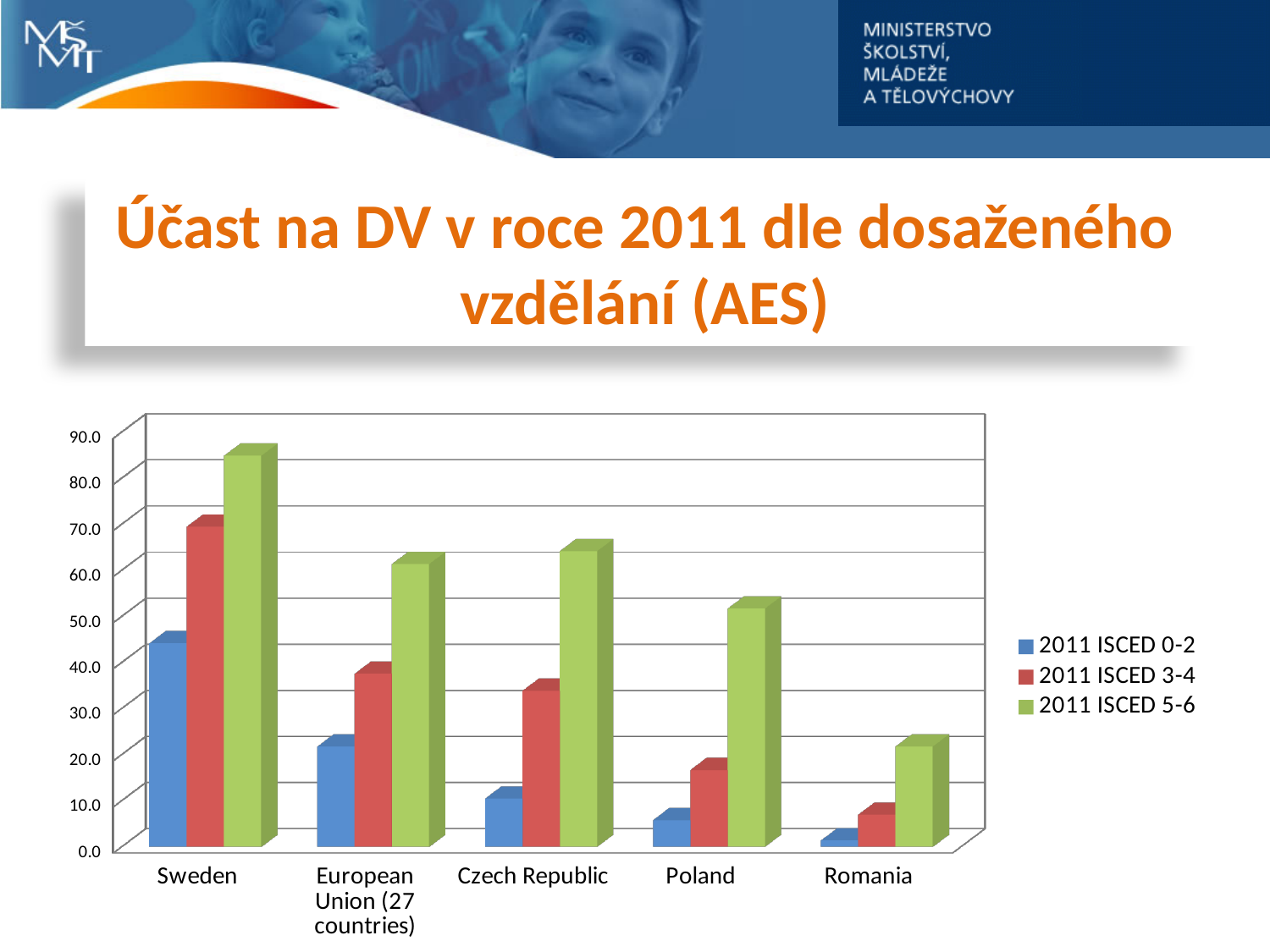
Is the 2011 ISCED 3-4 value for Czech Republic greater or less than 40? less What kind of chart is shown on the slide? bar chart Which category has the highest value for the 2011 ISCED 5-6 series? Sweden Is the 2011 ISCED 5-6 value for Romania greater or less than 30? less Is the 2011 ISCED 5-6 value for Sweden greater or less than 80? greater Which is larger, the 2011 ISCED 3-4 value for Sweden or for European Union (27 countries)? Sweden Which category has the lowest value for the 2011 ISCED 0-2 series? Romania Does the 2011 ISCED 0-2 series rise or fall moving from Sweden to Romania along the x axis? fall How many series does the chart legend list? 3 How many countries or regions are shown on the x axis of the chart? 5 Which colour represents the 2011 ISCED 3-4 series in the chart? red